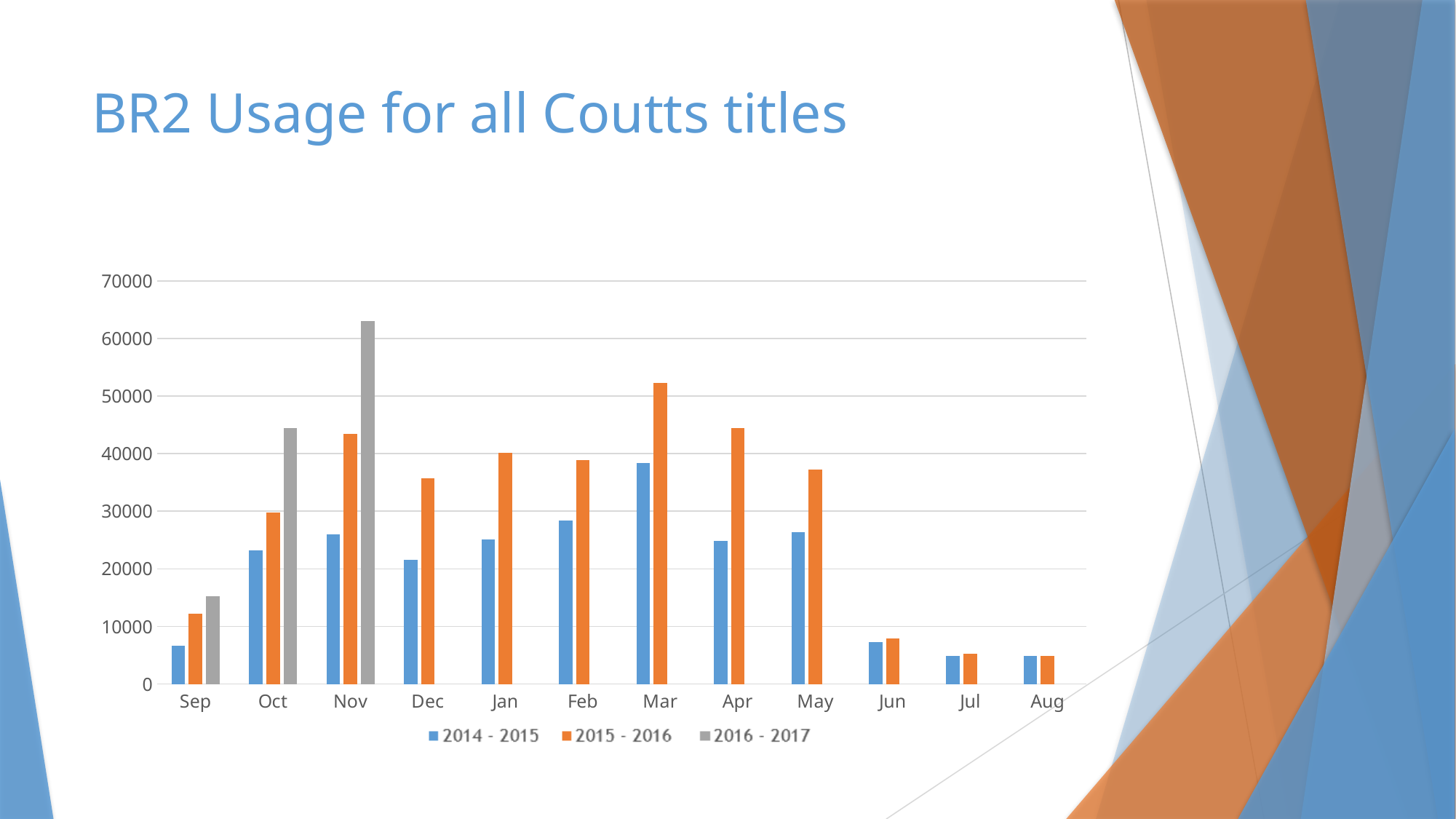
Is the value for Sep in the 2014 - 2015 series greater or less than 10000? less How many months are shown on the x axis? 12 What kind of chart is shown on the slide? bar chart Is the value for Nov in the 2016 - 2017 series greater or less than 60000? greater In which month is the 2015 - 2016 series highest? Mar How many series does the legend list? 3 In which month is the 2016 - 2017 series highest? Nov What is the title of the chart? BR2 Usage for all Coutts titles Is the value for Mar in the 2015 - 2016 series greater or less than 50000? greater For Apr, which series has the larger value, 2014 - 2015 or 2015 - 2016? 2015 - 2016 In which month is the 2014 - 2015 series highest? Mar In which month is the 2016 - 2017 series lowest? Sep